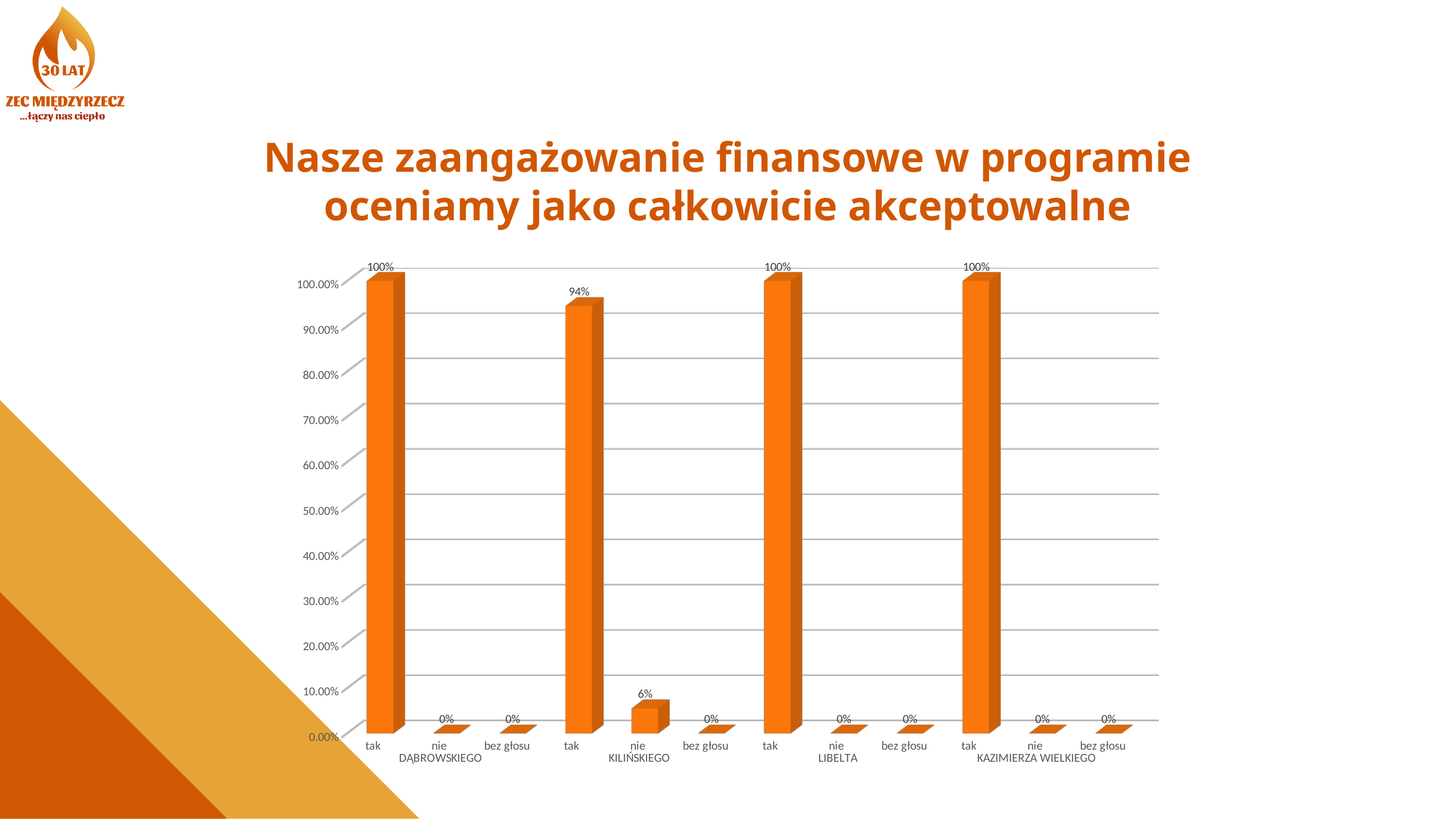
How many bars are plotted on the chart? 12 What is the value for "tak" under KILIŃSKIEGO? 94% What is the value for "nie" under KILIŃSKIEGO? 6% What is the value for "bez głosu" under LIBELTA? 0% What is the title of the slide above the chart? Nasze zaangażowanie finansowe w programie oceniamy jako całkowicie akceptowalne Which group has the lowest "tak" value? KILIŃSKIEGO What kind of chart is shown on the slide? bar chart What is the value for "tak" under DĄBROWSKIEGO? 100% How many groups (street names) are shown on the x axis? 4 Is the value for "tak" under KILIŃSKIEGO greater or less than 90.00%? greater What is the difference between the "tak" and "nie" values under KILIŃSKIEGO? 88% Which is larger: "tak" under KILIŃSKIEGO or "tak" under LIBELTA? tak under LIBELTA